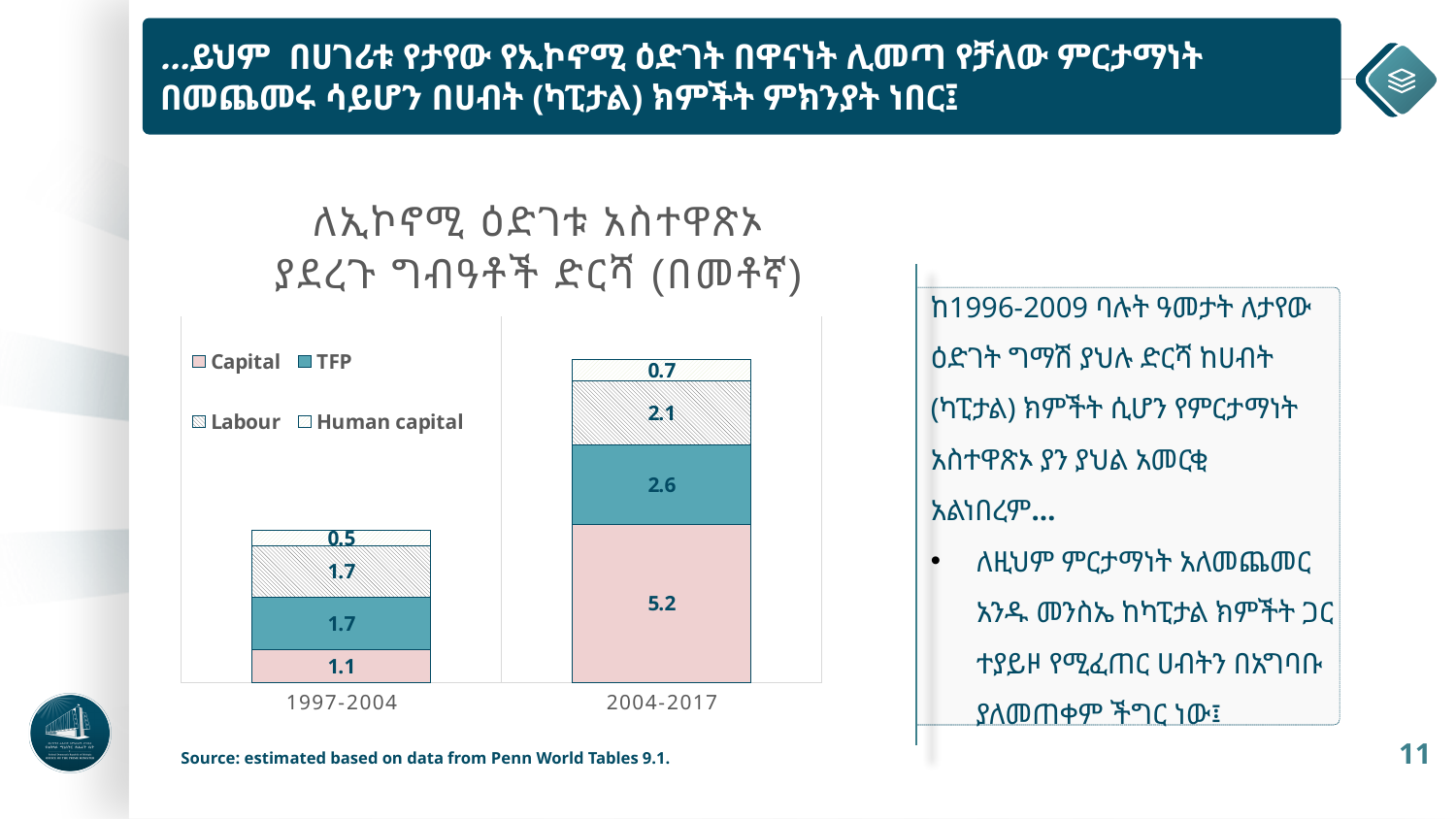
Which series has the largest value in the 2004-2017 bar? Capital What is the TFP contribution for 1997-2004? 1.7 What is the total of the stacked bar for 1997-2004? 5.0 What is the total of the stacked bar for 2004-2017? 10.6 What is the Labour contribution for 2004-2017? 2.1 What kind of chart is shown on the slide? Stacked bar chart What is the difference between the Capital contribution in 2004-2017 and in 1997-2004? 4.1 What is the Capital contribution for 2004-2017? 5.2 Which series has the smallest value in the 1997-2004 bar? Human capital What is the Human capital contribution for 2004-2017? 0.7 Is the TFP contribution larger in 1997-2004 or in 2004-2017? 2004-2017 How many series does the legend list? 4